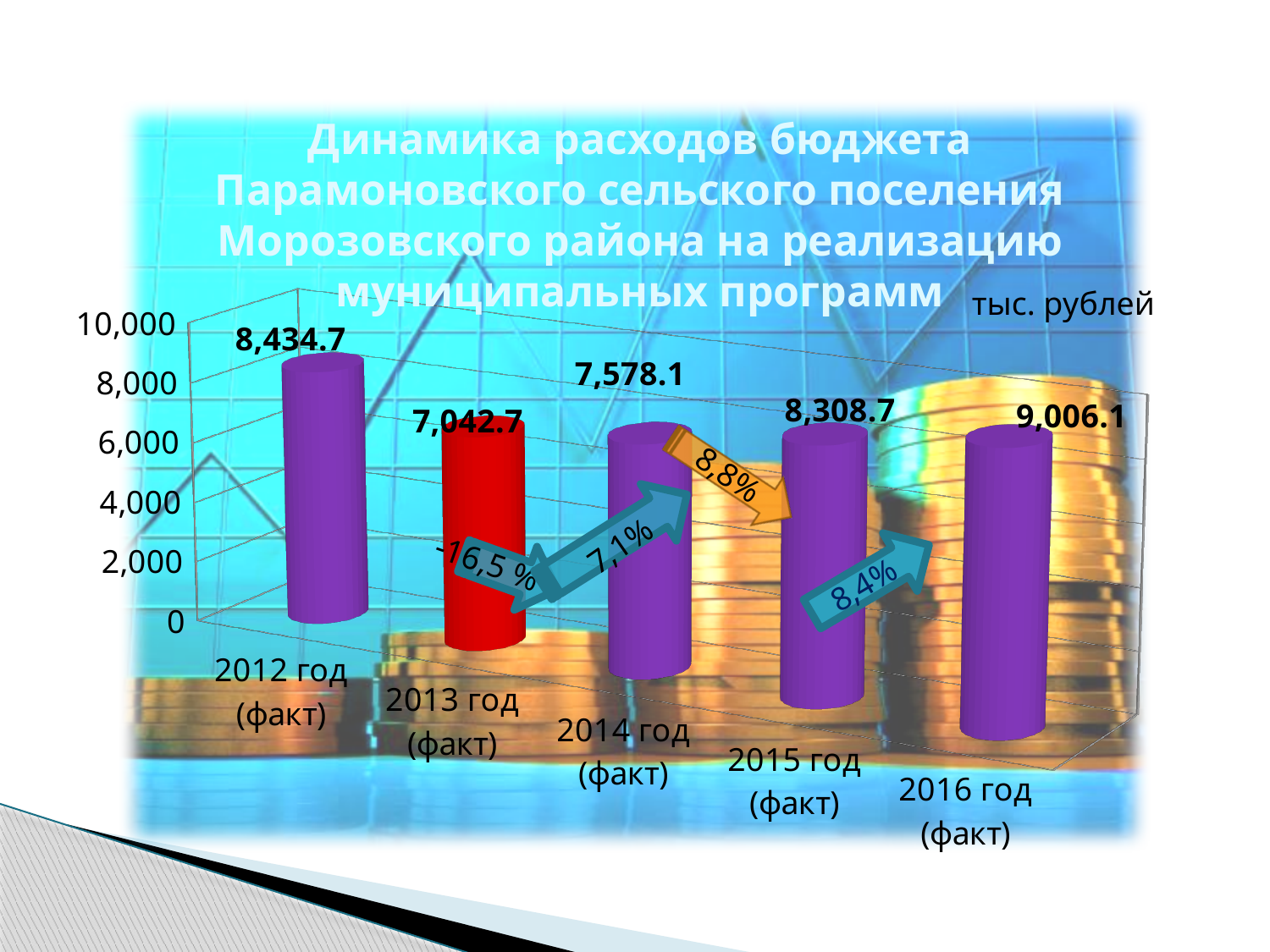
Which is larger, the value for 2012 год (факт) or 2015 год (факт)? 2012 год (факт) Is the value for 2014 год (факт) greater or less than 8,000? less In what units are the values on the chart expressed? тыс. рублей What is the value for 2012 год (факт)? 8,434.7 How many years are shown on the chart? 5 Which year has the lowest value? 2013 год (факт) Do the values rise or fall from 2013 год (факт) to 2016 год (факт)? rise What kind of chart is shown on the slide? bar chart What is the difference between the values for 2016 год (факт) and 2015 год (факт)? 697.4 What is the value for 2016 год (факт)? 9,006.1 What is the value for 2013 год (факт)? 7,042.7 Which year has the highest value? 2016 год (факт)